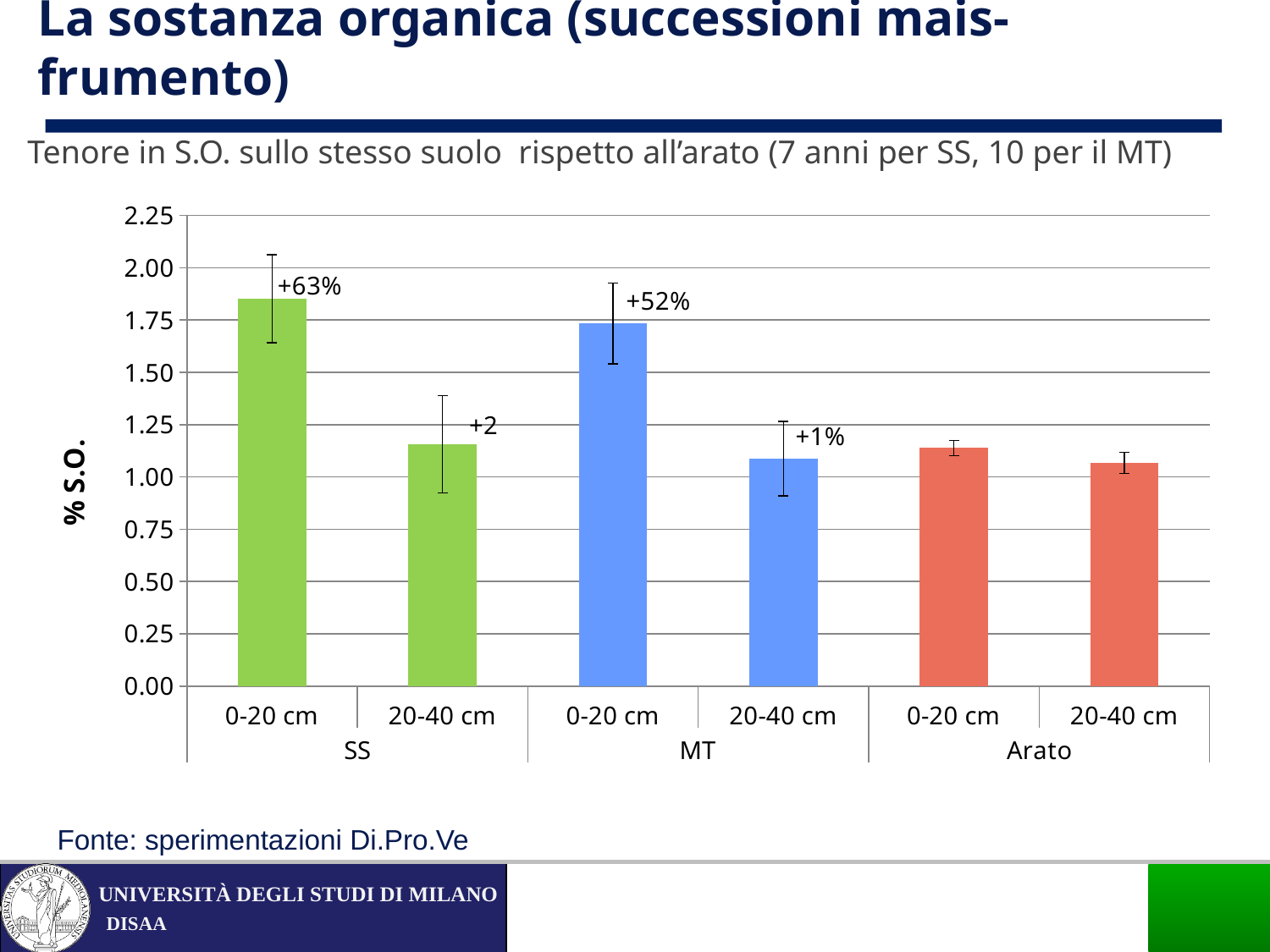
Within the MT group, which depth has the larger % S.O., 0-20 cm or 20-40 cm? 0-20 cm What is the label of the y axis? % S.O. Is the % S.O. value for SS 20-40 cm greater or less than 1.25? less Is the % S.O. value for MT 0-20 cm greater or less than 1.50? greater Which bar has the highest % S.O. value? SS 0-20 cm What kind of chart is shown on the slide? bar chart How many treatment groups (SS, MT, Arato) are shown along the x axis? 3 Is the % S.O. value for Arato 0-20 cm greater or less than 1.00? greater How many bars are plotted in the chart? 6 What percentage increase is annotated above the SS 0-20 cm bar? +63% Which is larger, the % S.O. for SS 0-20 cm or for MT 0-20 cm? SS 0-20 cm